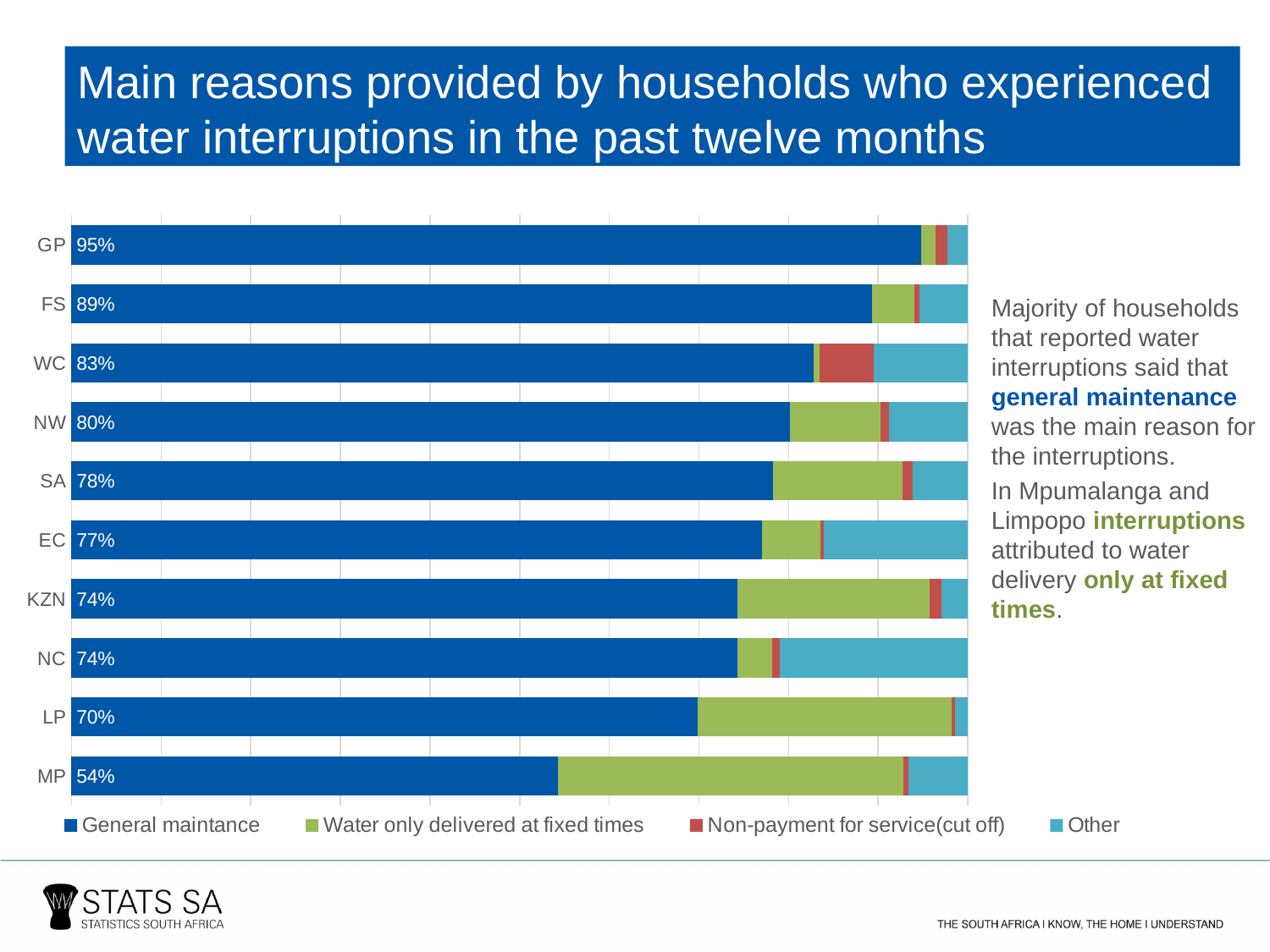
What percentage of households in GP cited general maintenance as the reason for water interruptions? 95% What is the difference between the General maintenance values for FS and EC? 12% What is the difference between the General maintenance values for GP and MP? 41% Which province has the highest share of households citing general maintenance? GP What is the General maintenance value for MP? 54% What type of chart is shown on the slide? Stacked bar chart How many series does the legend list? 4 What is the General maintenance value for KZN? 74% How many provinces/categories are shown on the chart? 10 Which has a larger General maintenance value, WC or NW? WC Which province has the lowest share of households citing general maintenance? MP Which series is shown in green in the legend? Water only delivered at fixed times